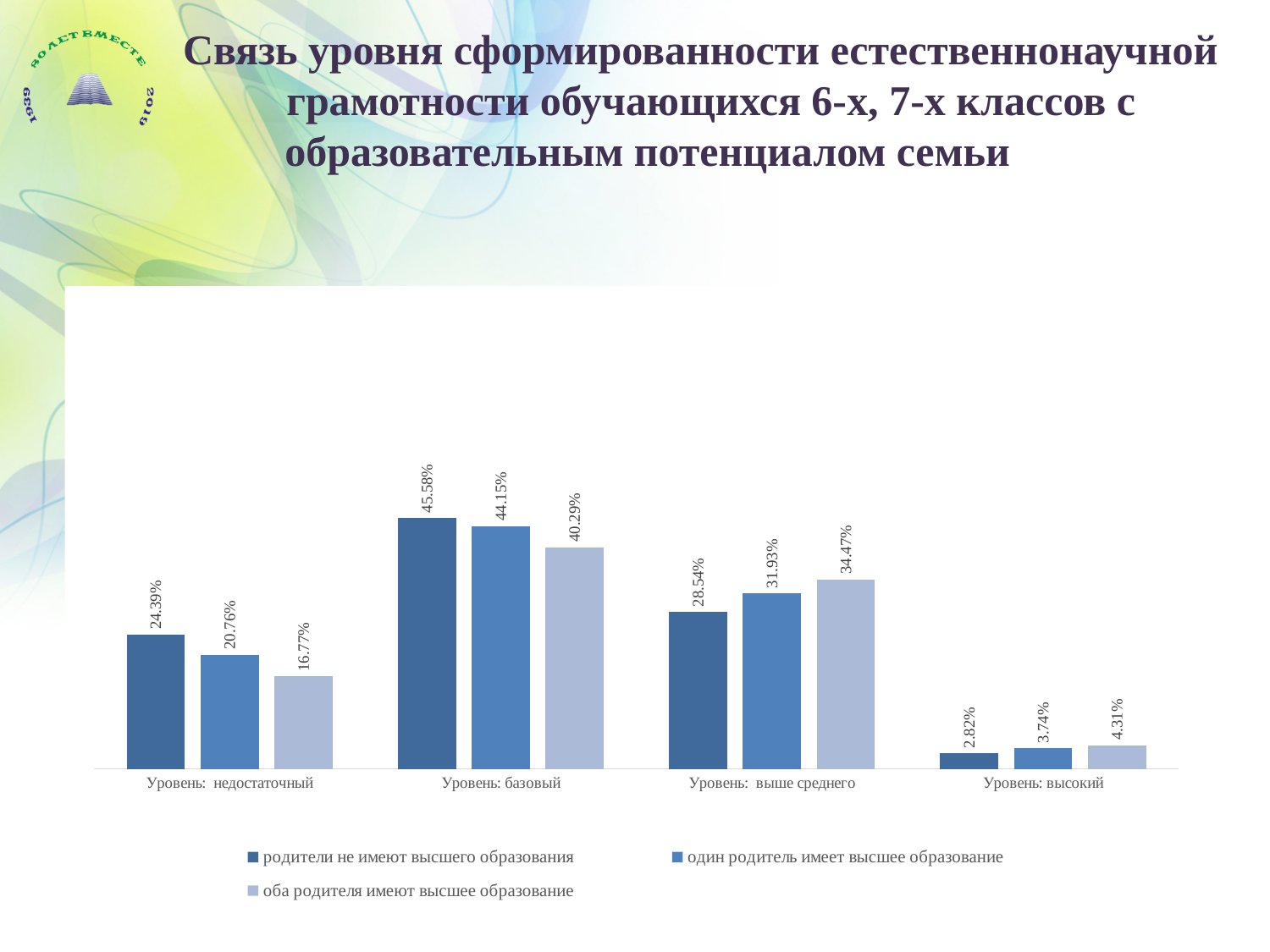
What is the value for "один родитель имеет высшее образование" at "Уровень: высокий"? 3.74% What kind of chart is shown on the slide? bar chart What is the difference between "родители не имеют высшего образования" and "оба родителя имеют высшее образование" at "Уровень: недостаточный"? 7.62% Which category has the lowest value for "родители не имеют высшего образования"? Уровень: высокий How many series does the legend list? 3 What is the value for "оба родителя имеют высшее образование" at "Уровень: выше среднего"? 34.47% What is the value for "родители не имеют высшего образования" at "Уровень: базовый"? 45.58% Across the three series at "Уровень: высокий", do the values rise or fall from "родители не имеют высшего образования" to "оба родителя имеют высшее образование"? rise How many categories are shown on the x axis? 4 Which category has the highest value for "оба родителя имеют высшее образование"? Уровень: базовый At "Уровень: выше среднего", which is larger: "родители не имеют высшего образования" or "оба родителя имеют высшее образование"? оба родителя имеют высшее образование What is the third legend entry? оба родителя имеют высшее образование